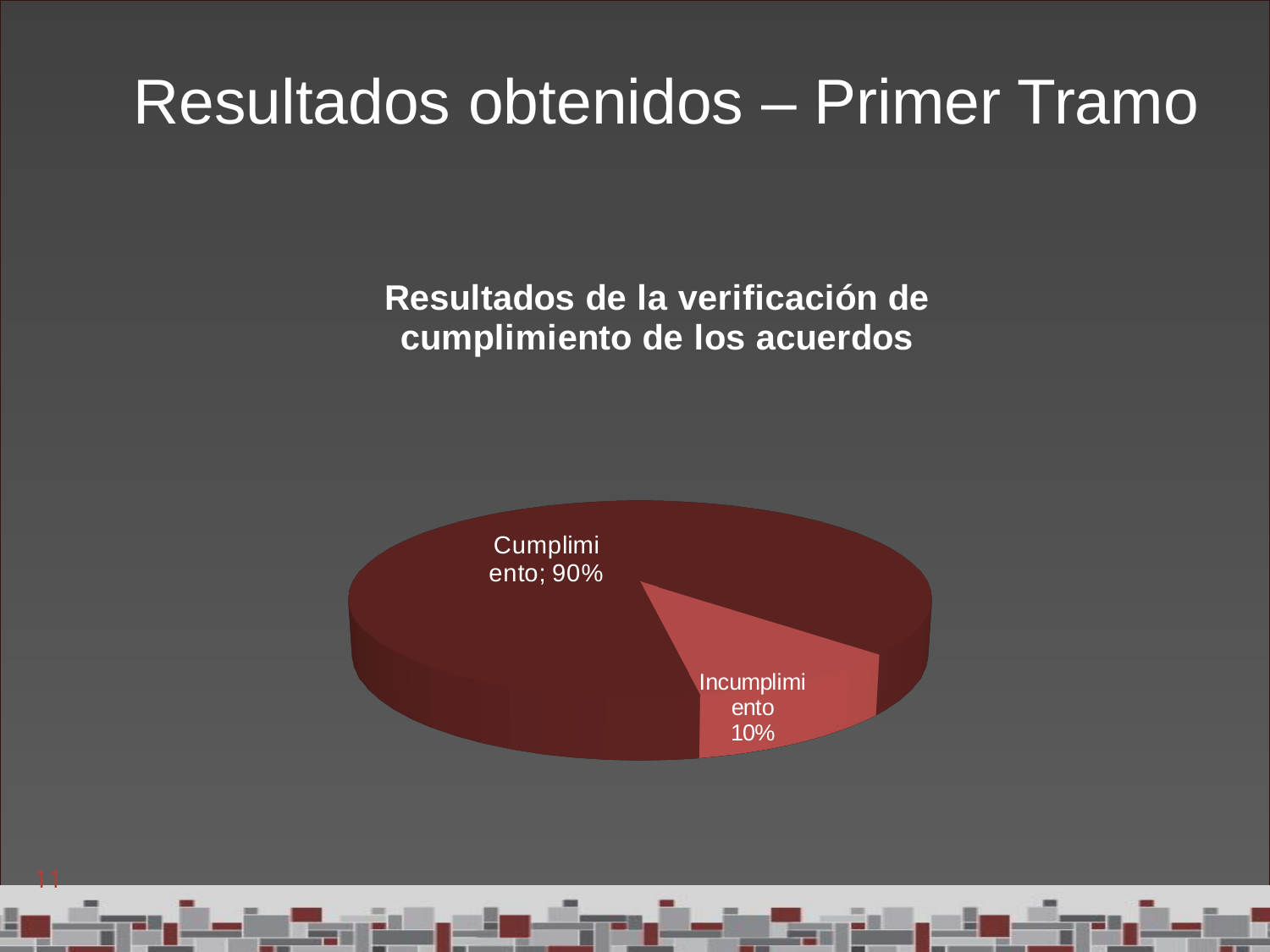
Which slice is the largest? Cumplimiento What is the value for Incumplimiento? 10% What is the value for Cumplimiento? 90% Which is larger, Cumplimiento or Incumplimiento? Cumplimiento What is the title of the chart? Resultados de la verificación de cumplimiento de los acuerdos Which slice is the smallest? Incumplimiento How many slices does the pie chart have? 2 What kind of chart is shown on the slide? pie chart What share of the pie does Incumplimiento represent? 10% What is the total of the two slices shown? 100% What is the difference between the Cumplimiento and Incumplimiento values? 80%